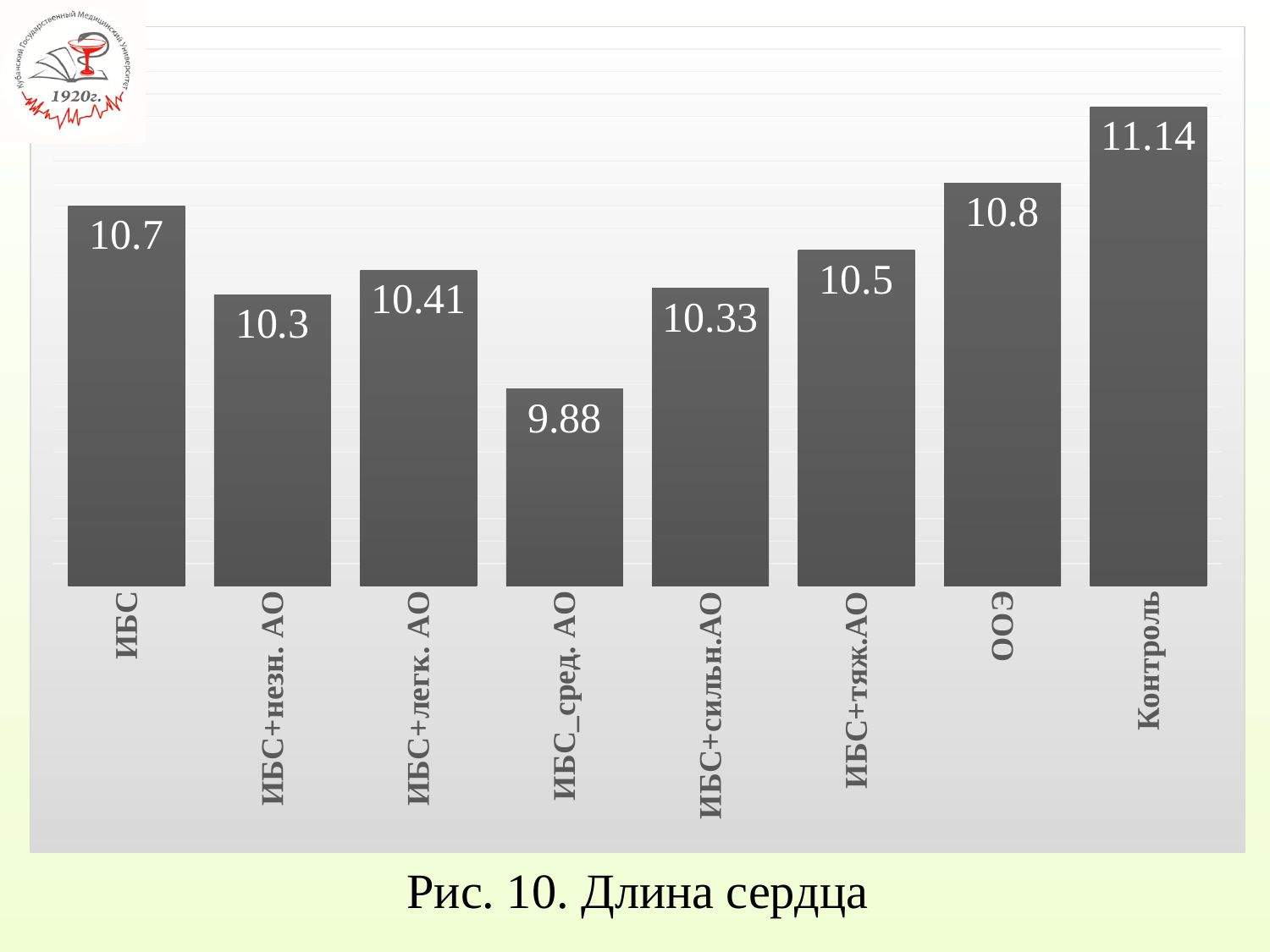
Which is larger, the value for ИБС+легк. АО or the value for ИБС+сильн.АО? ИБС+легк. АО What is the value for ИБС? 10.7 What is the value for ИБС_сред. АО? 9.88 What is the value for Контроль? 11.14 What is the difference between the values for Контроль and ИБС_сред. АО? 1.26 What kind of chart is shown on the slide? Bar chart How many categories are shown in the chart? 8 Which category has the highest value? Контроль What is the caption of the chart? Рис. 10. Длина сердца What is the value for ИБС+тяж.АО? 10.5 Which category has the lowest value? ИБС_сред. АО